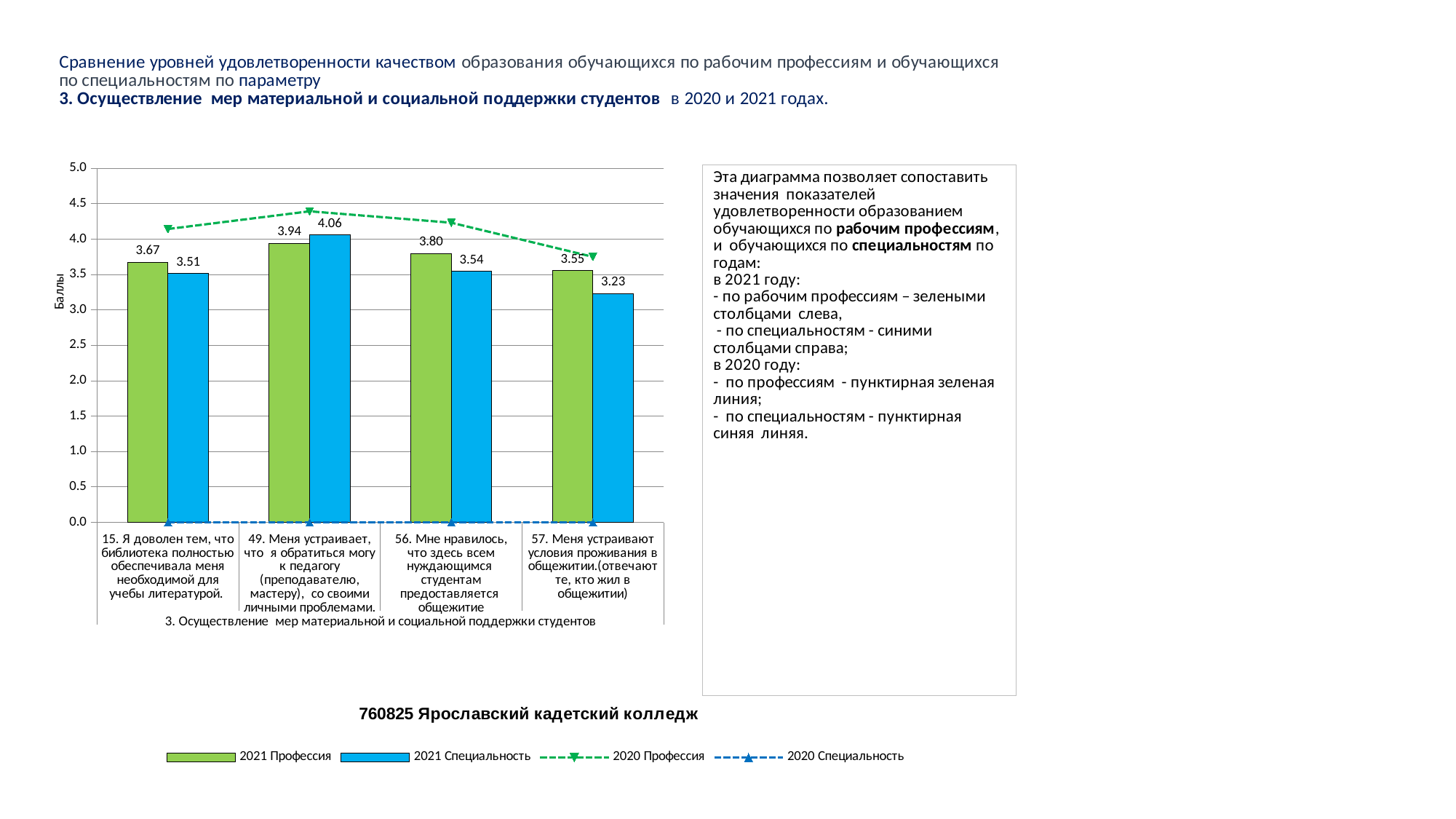
For category 49, which is larger: the 2021 Профессия bar or the 2021 Специальность bar? 2021 Специальность Which category has the highest 2021 Профессия bar? 49. Меня устраивает, что я обратиться могу к педагогу (преподавателю, мастеру), со своими личными проблемами. What is the value of the 2021 Профессия bar for category 15 (Я доволен тем, что библиотека полностью обеспечивала меня необходимой для учебы литературой)? 3.67 How many series does the chart legend list? 4 Which category has the lowest 2021 Специальность bar? 57. Меня устраивают условия проживания в общежитии.(отвечают те, кто жил в общежитии) How many categories are shown on the x axis of the chart? 4 What is the difference between the 2021 Профессия and 2021 Специальность values for category 56 (Мне нравилось, что здесь всем нуждающимся студентам предоставляется общежитие)? 0.26 Is the 2020 Профессия value for category 49 greater or less than 4.0? greater What is the label of the y axis of the chart? Баллы What is the value of the 2021 Специальность bar for category 49 (Меня устраивает, что я обратиться могу к педагогу)? 4.06 What kind of chart is shown on the slide? Bar chart with line series What is the value of the 2021 Специальность bar for category 57 (Меня устраивают условия проживания в общежитии)? 3.23